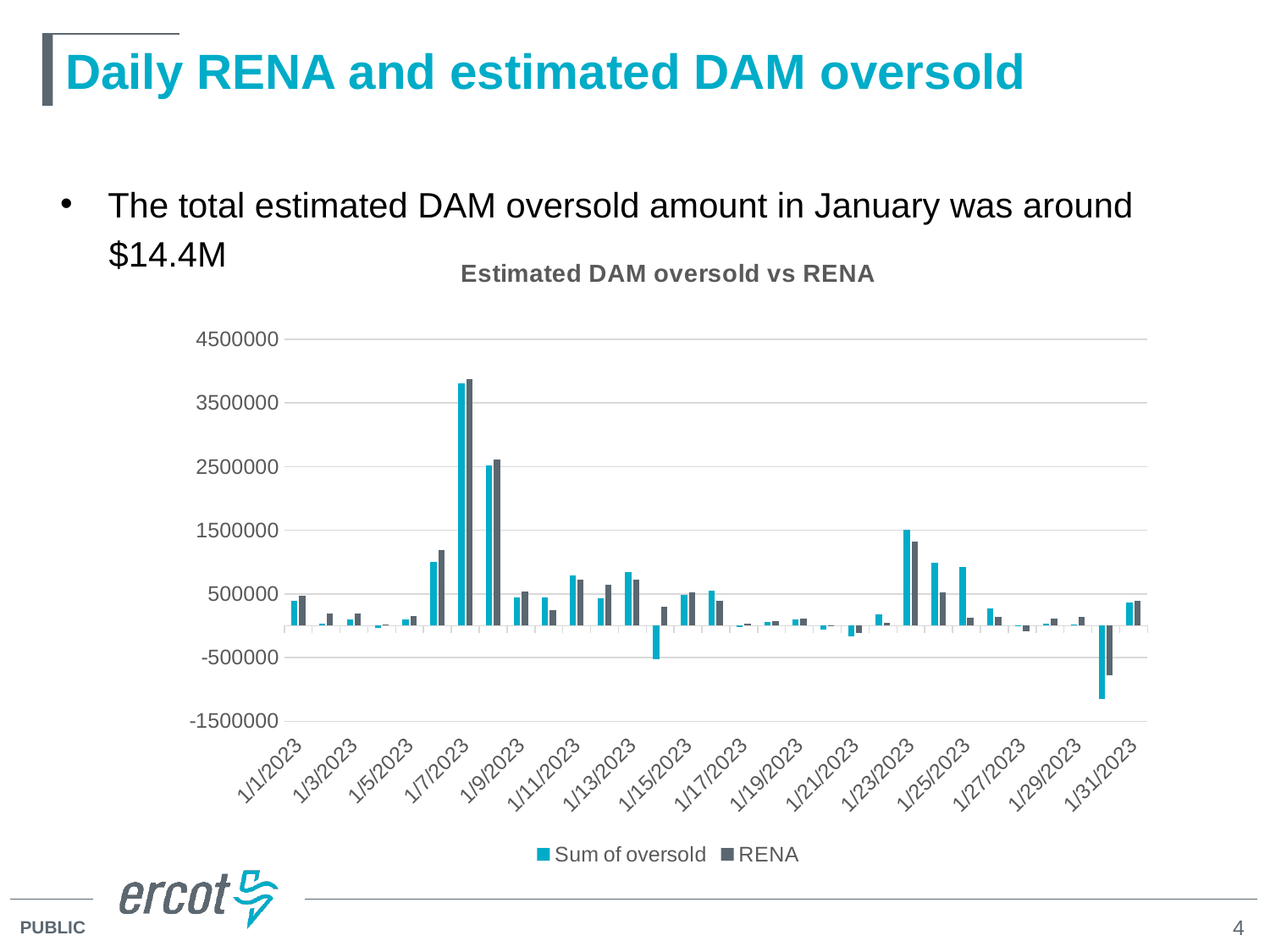
Is the RENA value for 1/7/2023 greater or less than 3500000? greater On which date does the Sum of oversold series reach its highest value? 1/7/2023 What are the two series named in the legend? Sum of oversold and RENA Is the Sum of oversold value for 1/9/2023 greater or less than 1500000? less Is the Sum of oversold value for 1/23/2023 greater or less than 500000? greater What is the title of the chart? Estimated DAM oversold vs RENA What type of chart is shown on the slide? Bar chart On which date does the RENA series reach its highest value? 1/7/2023 How many date labels are shown along the x axis? 16 On 1/25/2023, which series has the larger value, Sum of oversold or RENA? Sum of oversold How many series does the chart legend list? 2